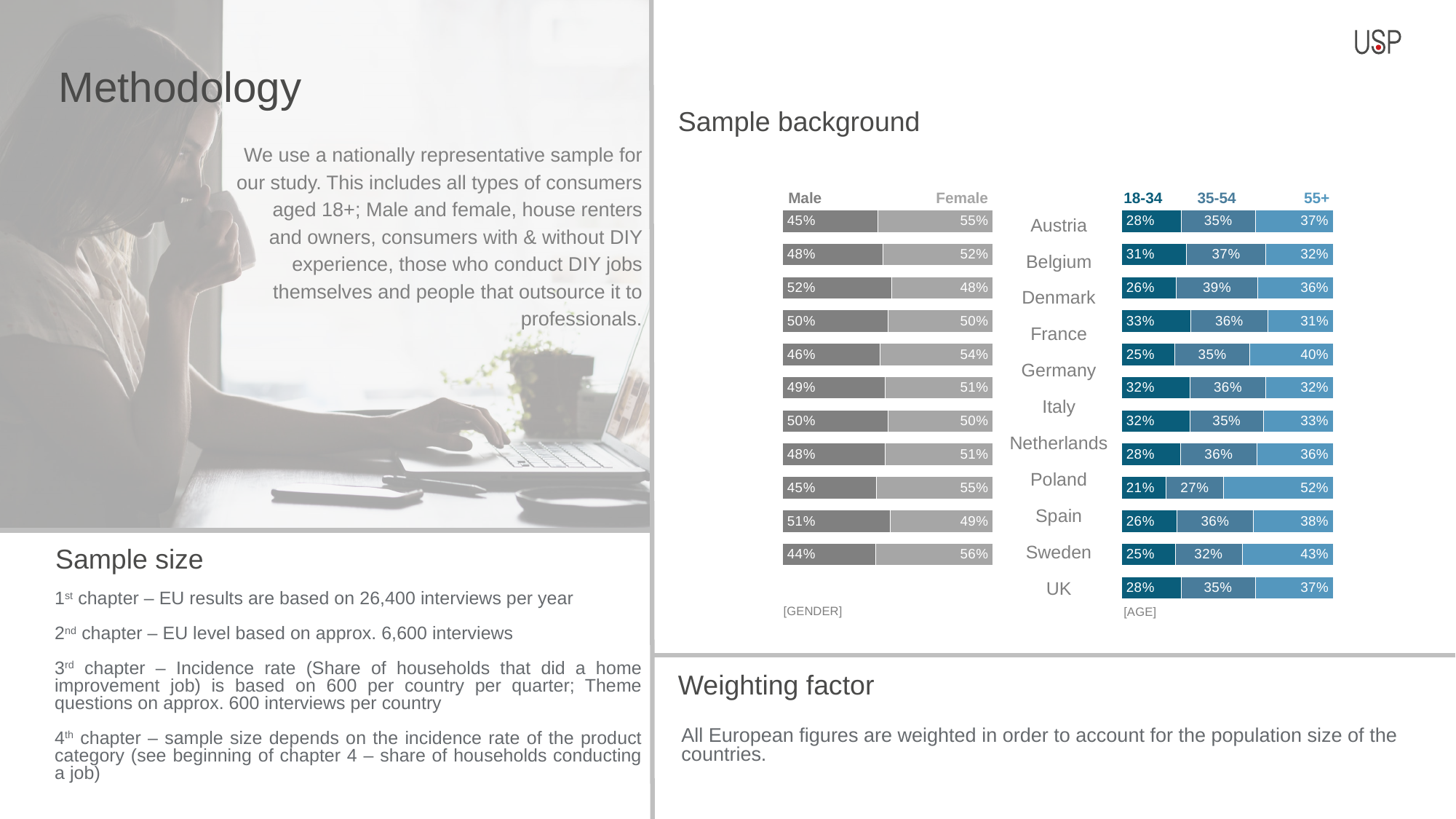
What type of chart is the gender chart? Stacked bar chart In the gender chart, which country has the lowest Male share? UK In the gender chart, what is the Female share for the UK? 56% In the gender chart, what is the difference between the Female and Male shares for Austria? 10% In the age chart, is the 35-54 share for Denmark larger or smaller than the 35-54 share for Poland? larger In the age chart, which country has the lowest 18-34 share? Spain How many series does the age chart's legend list? 3 In the age chart, what is the 55+ share for Spain? 52% In the age chart, which country has the highest 55+ share? Spain In the age chart, what is the 18-34 share for France? 33% How many countries are shown in the age chart? 11 In the gender chart, what is the Male share for Denmark? 52%